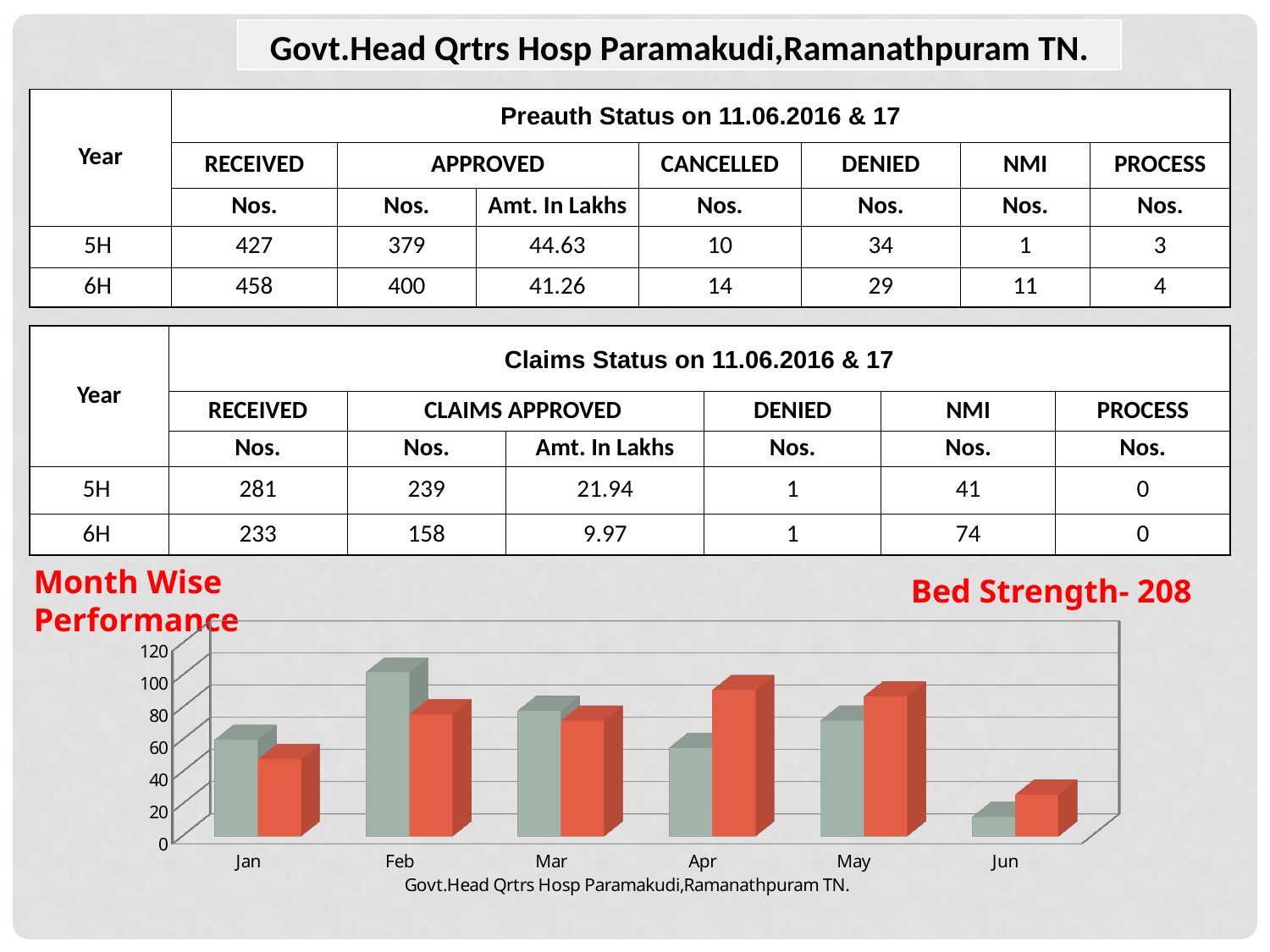
What kind of chart is shown under the heading "Month Wise Performance"? bar chart In the Month Wise Performance chart, is the red bar for Jan greater or less than 80? less What caption is printed below the x axis of the Month Wise Performance chart? Govt.Head Qrtrs Hosp Paramakudi,Ramanathpuram TN. In the Month Wise Performance chart, for Feb, which bar is taller: the grey bar or the red bar? the grey bar In the Month Wise Performance chart, is the grey bar for Jun greater or less than 40? less How many months are shown on the x axis of the Month Wise Performance chart? 6 In the Month Wise Performance chart, which month has the shortest grey bar? Jun In the Month Wise Performance chart, which month has the tallest grey bar? Feb In the Month Wise Performance chart, for Apr, which bar is taller: the grey bar or the red bar? the red bar In the Month Wise Performance chart, is the red bar for Apr greater or less than 80? greater In the Month Wise Performance chart, which month has the shortest red bar? Jun